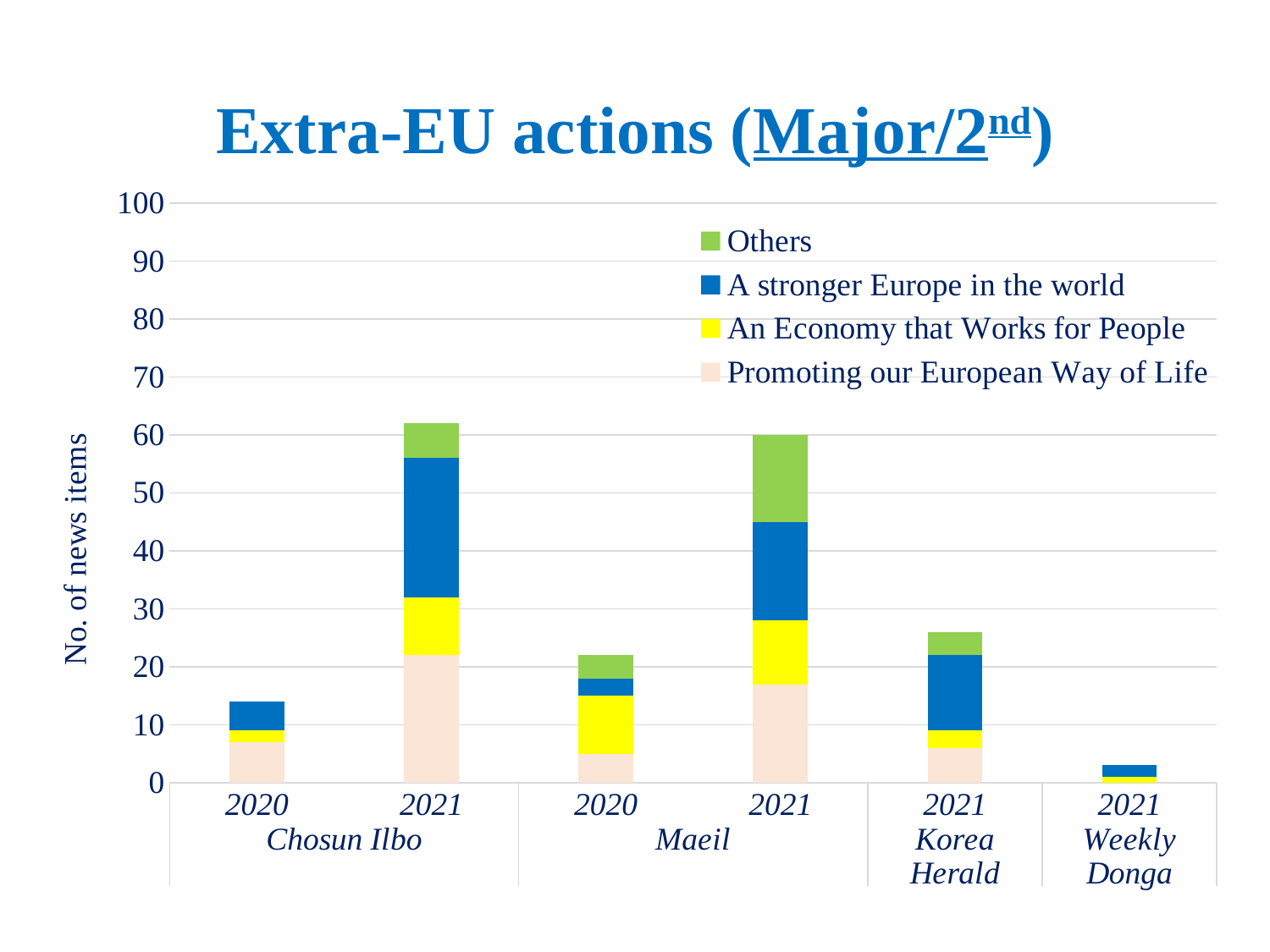
Is the total for Maeil 2020 greater or less than 30? less What kind of chart is shown on the slide? stacked bar chart Which has a larger total, Korea Herald 2021 or Weekly Donga 2021? Korea Herald 2021 Is the total for Weekly Donga 2021 greater or less than 10? less What is the label on the vertical axis? No. of news items For Chosun Ilbo, does the total rise or fall from 2020 to 2021? rise Which has a larger total, Chosun Ilbo 2020 or Maeil 2020? Maeil 2020 Is the total for Chosun Ilbo 2021 greater or less than 50? greater How many series does the legend list? 4 Which bar has the lowest total number of news items? Weekly Donga 2021 How many bars are plotted in the chart? 6